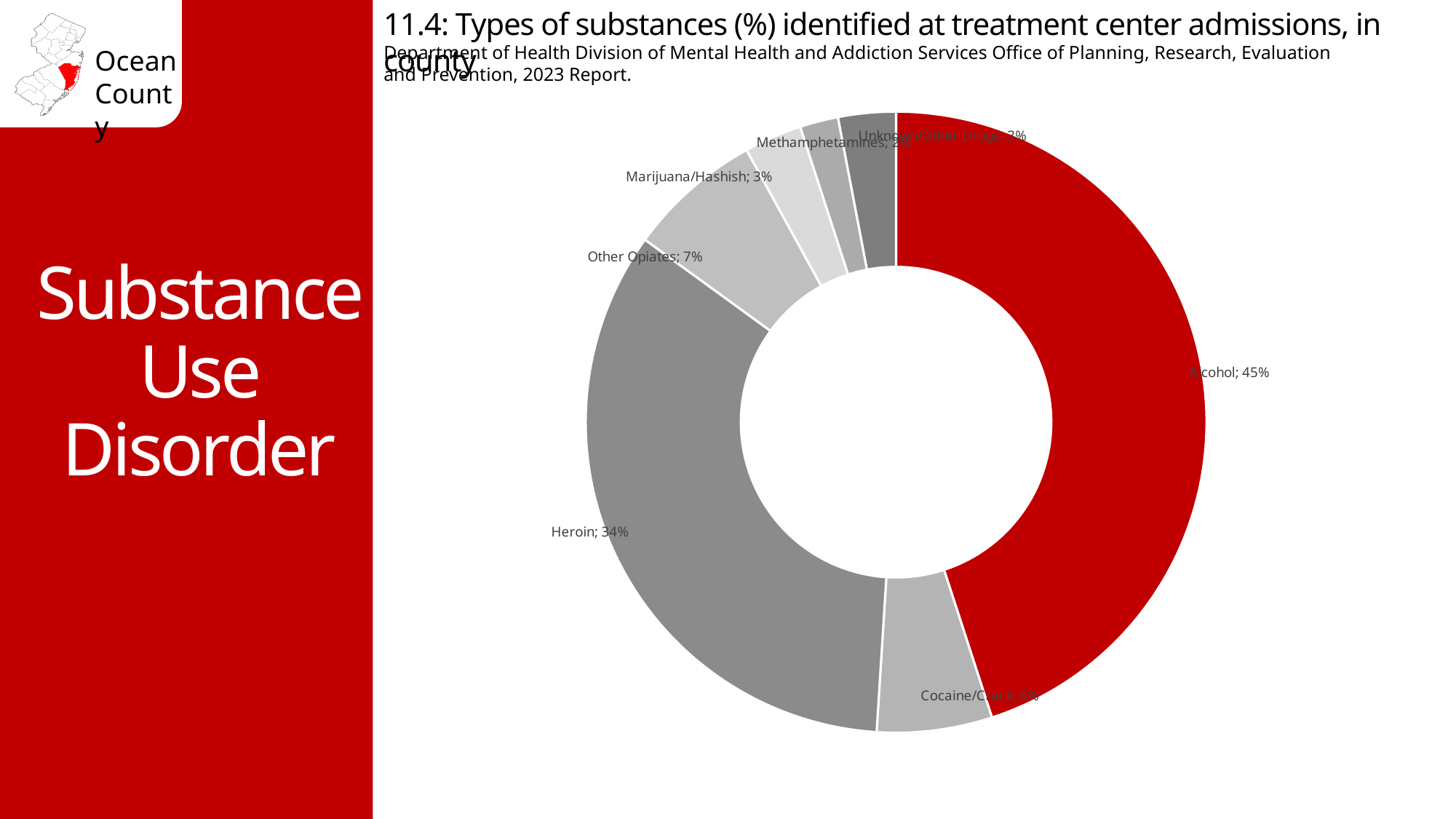
What is the combined share of Alcohol and Heroin? 79% What percentage is shown for Cocaine/Crack? 6% What colour is the Alcohol slice? Red What kind of chart is shown on the slide? Doughnut (pie) chart What percentage is shown for Marijuana/Hashish? 3% What percentage is shown for Heroin? 34% What percentage of treatment center admissions identified Alcohol? 45% How many percentage points higher is Alcohol than Heroin? 11 percentage points What is the figure number given in the chart title? 11.4 Which is larger, the share for Heroin or the share for Other Opiates? Heroin Which substance has the largest share of admissions? Alcohol What percentage is shown for Other Opiates? 7%